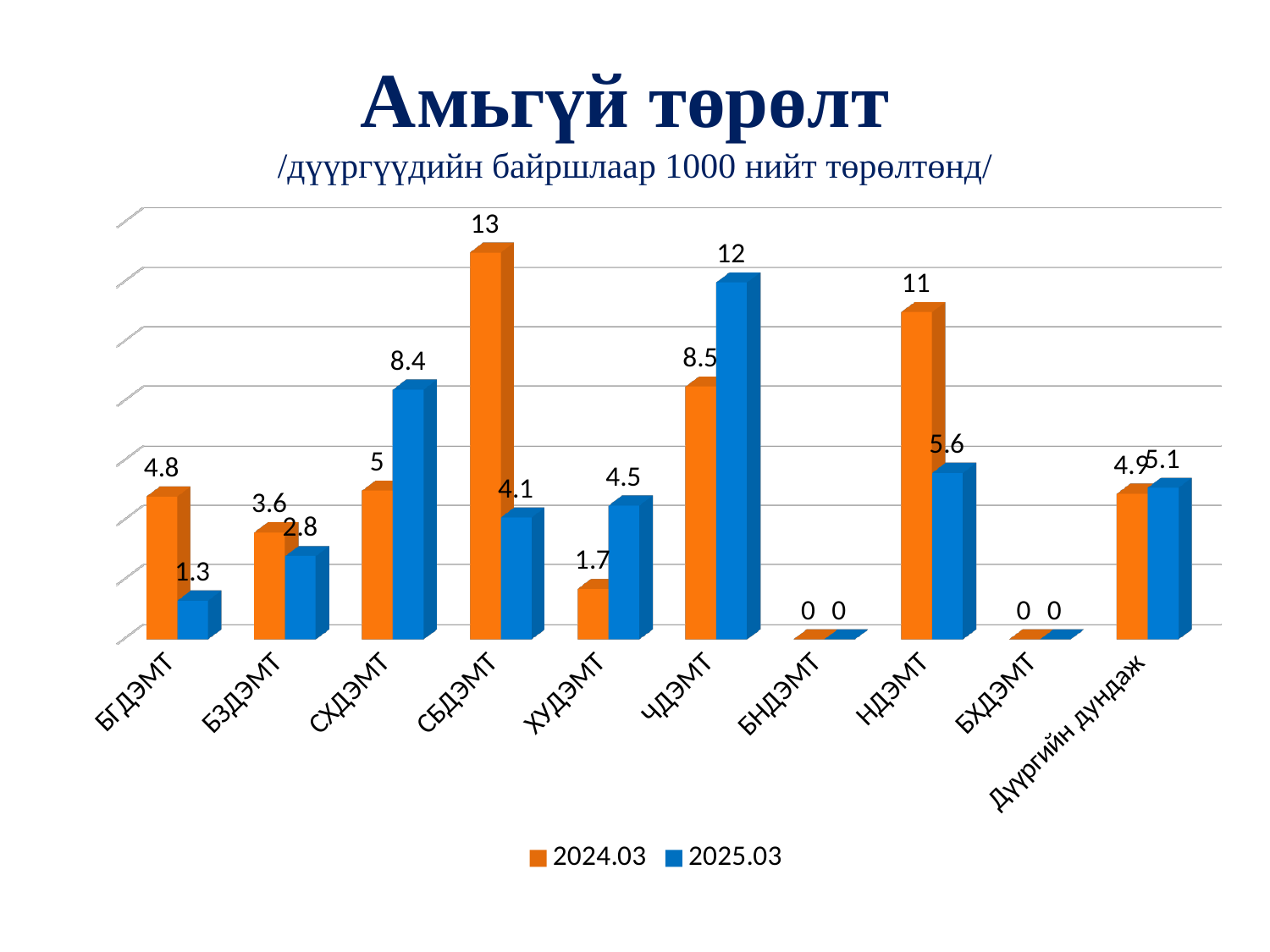
How many series does the legend list? 2 What is the 2024.03 value for Дүүргийн дундаж? 4.9 What is the value for СБДЭМТ in the 2024.03 series? 13 Which colour represents the 2025.03 series? Blue What is the 2025.03 value for СХДЭМТ? 8.4 What is the value for ЧДЭМТ in the 2025.03 series? 12 How many categories are shown on the x axis? 10 Which category has the highest value in the 2025.03 series? ЧДЭМТ Which category has the highest value in the 2024.03 series? СБДЭМТ Which is larger for ХУДЭМТ: the 2024.03 value or the 2025.03 value? 2025.03 What is the difference between the 2024.03 and 2025.03 values for НДЭМТ? 5.4 What kind of chart is shown on the slide? Bar chart